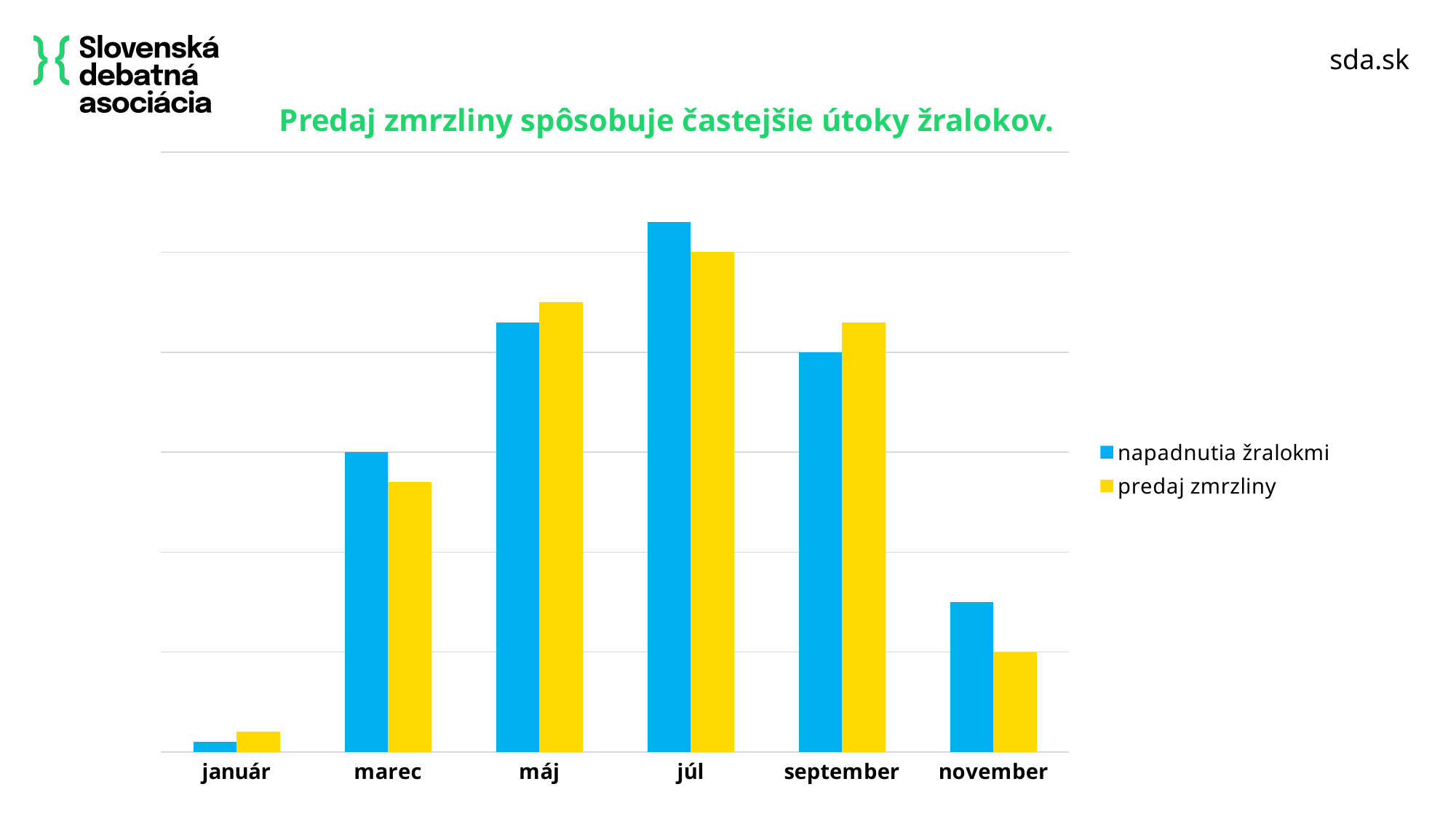
In september, which series has the larger value, napadnutia žralokmi or predaj zmrzliny? predaj zmrzliny In which month is the value for napadnutia žralokmi highest? júl How many months are shown on the x axis of the chart? 6 In which month is the value for napadnutia žralokmi lowest? január What kind of chart is shown on the slide? bar chart How many series does the chart's legend list? 2 What is the title of the chart? Predaj zmrzliny spôsobuje častejšie útoky žralokov. In marec, which series has the larger value, napadnutia žralokmi or predaj zmrzliny? napadnutia žralokmi In which month is the value for predaj zmrzliny highest? júl Do the values for predaj zmrzliny rise or fall from júl to november? fall In which month is the value for predaj zmrzliny lowest? január Do the values for napadnutia žralokmi rise or fall from január to júl? rise